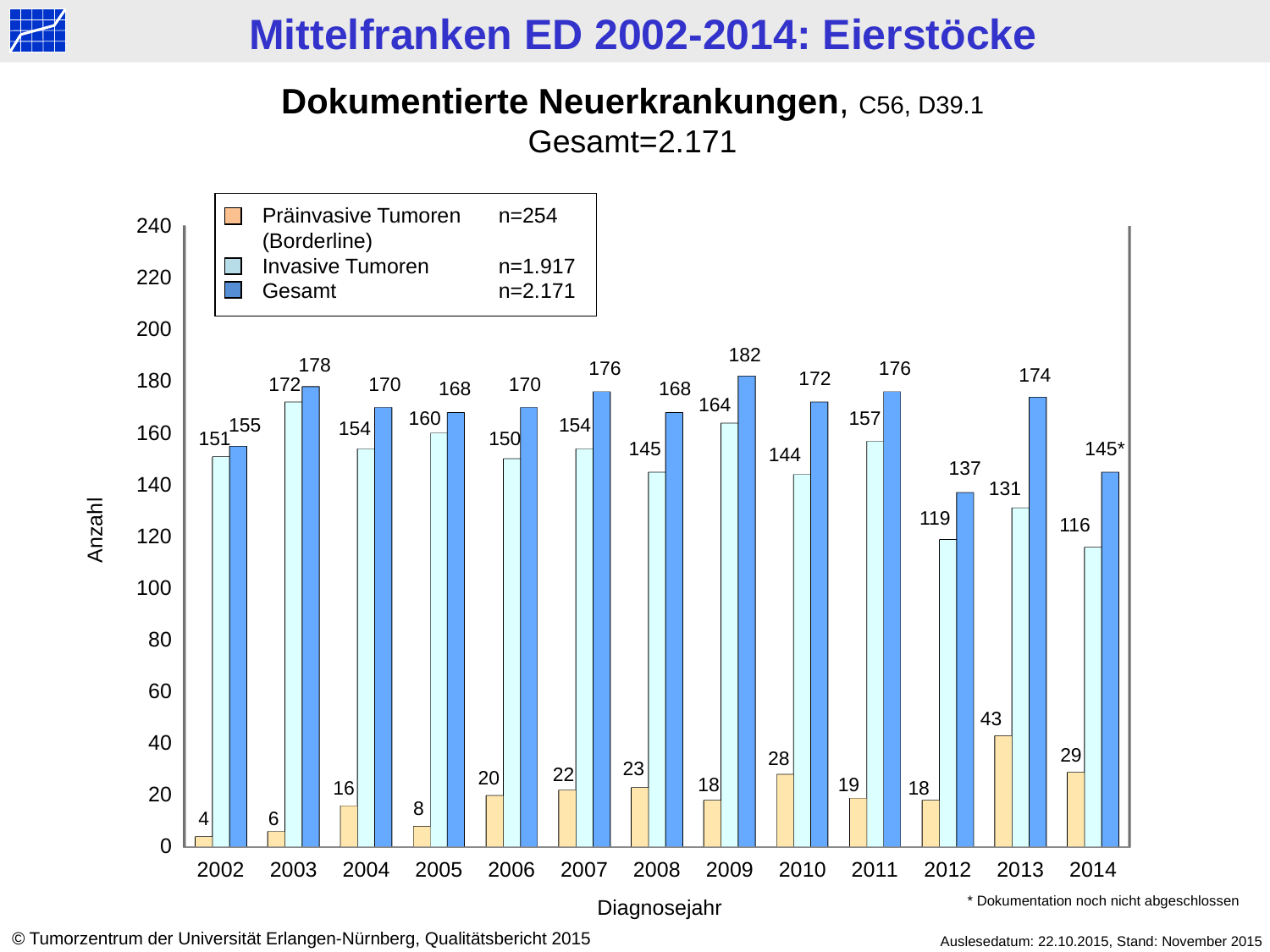
What is the value of Gesamt for 2009? 182 Is the Gesamt value for 2014 greater or less than 160? less What is the n value given in the legend for Invasive Tumoren? n=1.917 What is the difference between the Gesamt values for 2003 and 2012? 41 In which year is the Gesamt value highest? 2009 How many series does the legend list? 3 Which is larger, the Invasive Tumoren value for 2005 or for 2010? 2005 What is the value of Präinvasive Tumoren (Borderline) for 2013? 43 What is the value of Invasive Tumoren for 2012? 119 How many years are shown on the x axis? 13 In which year is the Präinvasive Tumoren (Borderline) value lowest? 2002 What kind of chart is shown on the slide? bar chart